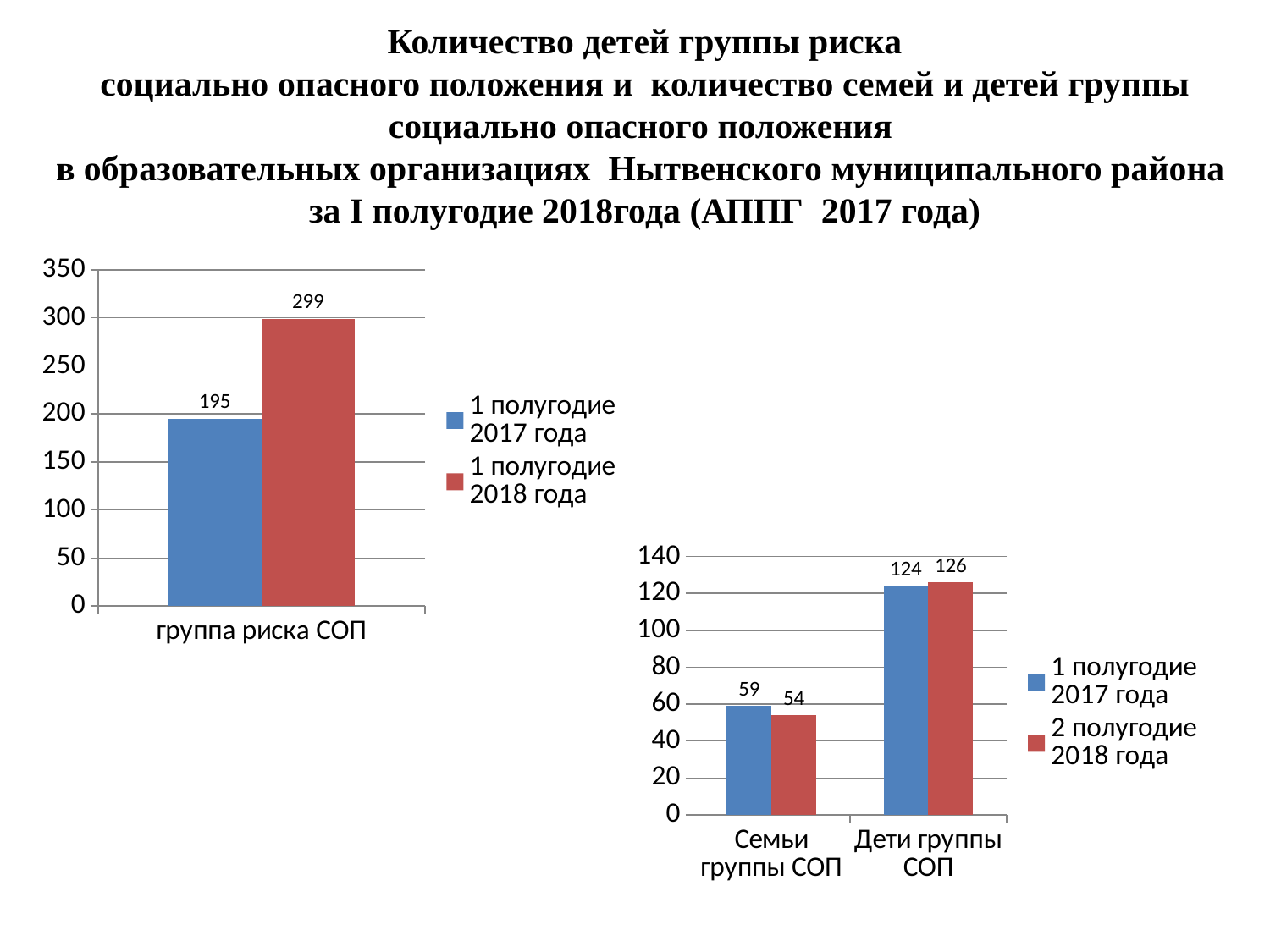
In the right chart, what is the value for 'Семьи группы СОП' in '1 полугодие 2017 года'? 59 How many series does the legend of the left chart list? 2 In the left chart, what is the value for 'группа риска СОП' in '1 полугодие 2018 года'? 299 How many categories are shown on the x axis of the right chart? 2 In the left chart, which series has the larger value for 'группа риска СОП'? 1 полугодие 2018 года In the left chart, what is the difference between the 2018 and 2017 values for 'группа риска СОП'? 104 In the right chart, what is the value for 'Дети группы СОП' in '1 полугодие 2017 года'? 124 In the left chart, what is the value for 'группа риска СОП' in '1 полугодие 2017 года'? 195 In the right chart, what is the value for 'Дети группы СОП' in '2 полугодие 2018 года'? 126 In the right chart, what is the value for 'Семьи группы СОП' in '2 полугодие 2018 года'? 54 In the right chart, what is the difference between the 2017 and 2018 values for 'Семьи группы СОП'? 5 What kind of chart is the left chart? bar chart